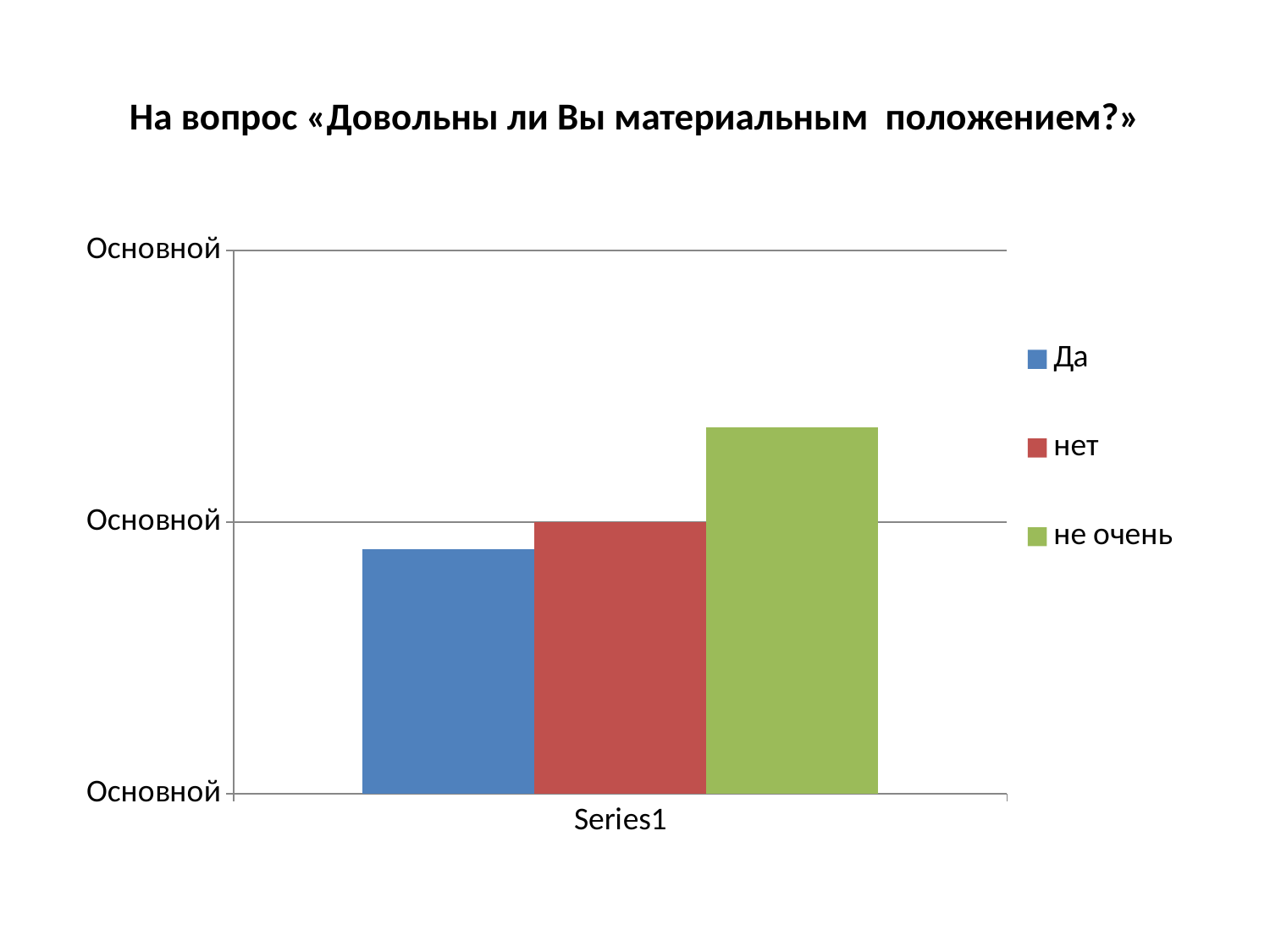
Which response has the tallest bar? не очень Which response has the shortest bar? Да Which bar is taller, "не очень" or "Да"? не очень What is the title of the chart? На вопрос «Довольны ли Вы материальным положением?» How many bars are plotted in the chart? 3 Which bar is taller, "не очень" or "нет"? не очень What kind of chart is shown on the slide? bar chart What colour is the bar for "не очень"? green How many entries does the legend list? 3